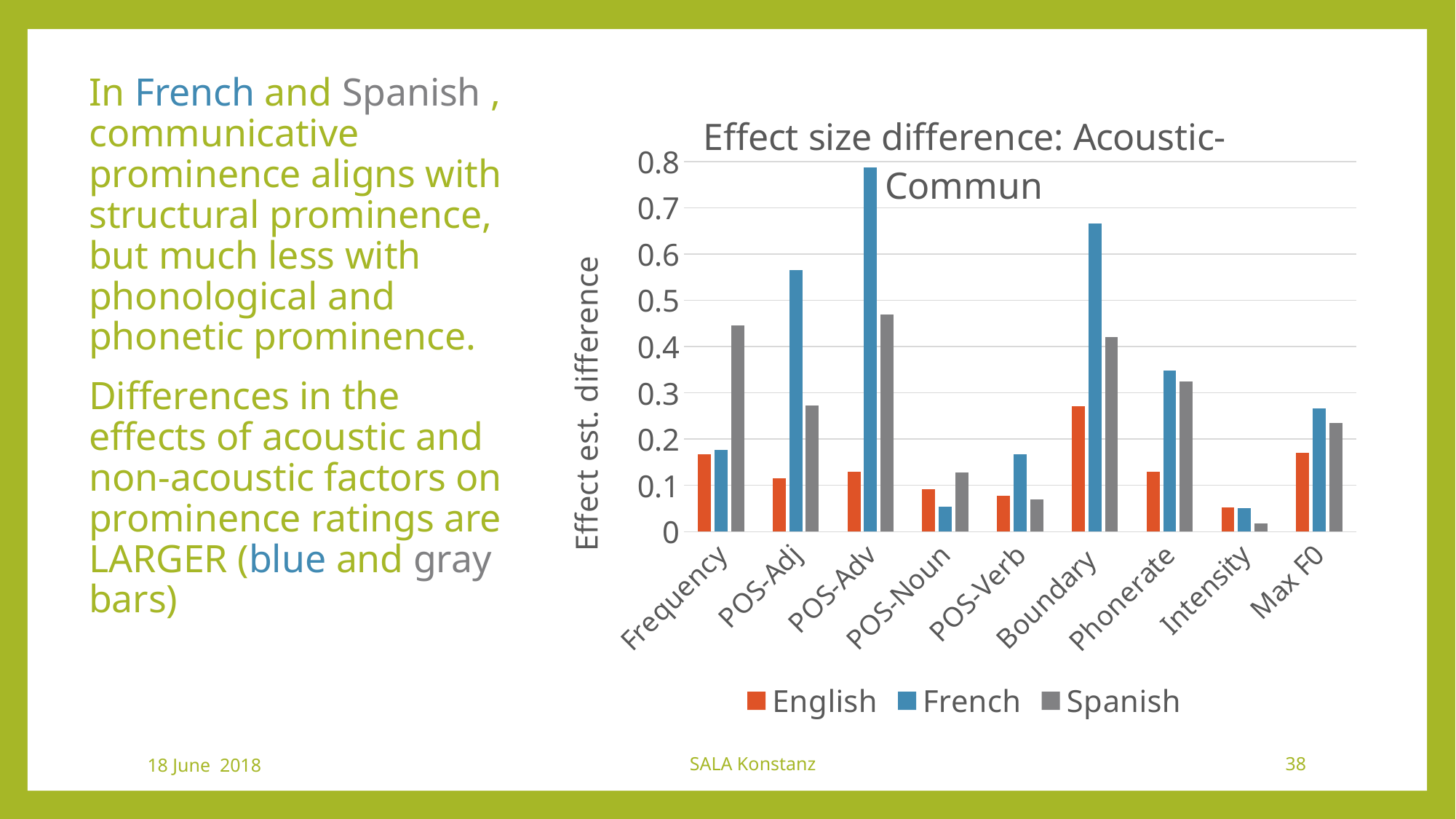
What kind of chart is shown on the slide? bar chart For which category is the French value highest? POS-Adv Is the English value for Boundary greater or less than 0.3? less Is the Spanish value for Frequency greater or less than 0.4? greater What is the label of the y axis? Effect est. difference How many series does the legend list? 3 How many categories are shown on the x axis? 9 For which category is the Spanish value lowest? Intensity For which category is the English value highest? Boundary Is the French value for POS-Adv greater or less than 0.7? greater For POS-Noun, which is larger: the English value or the French value? English For Boundary, which is larger: the French value or the Spanish value? French